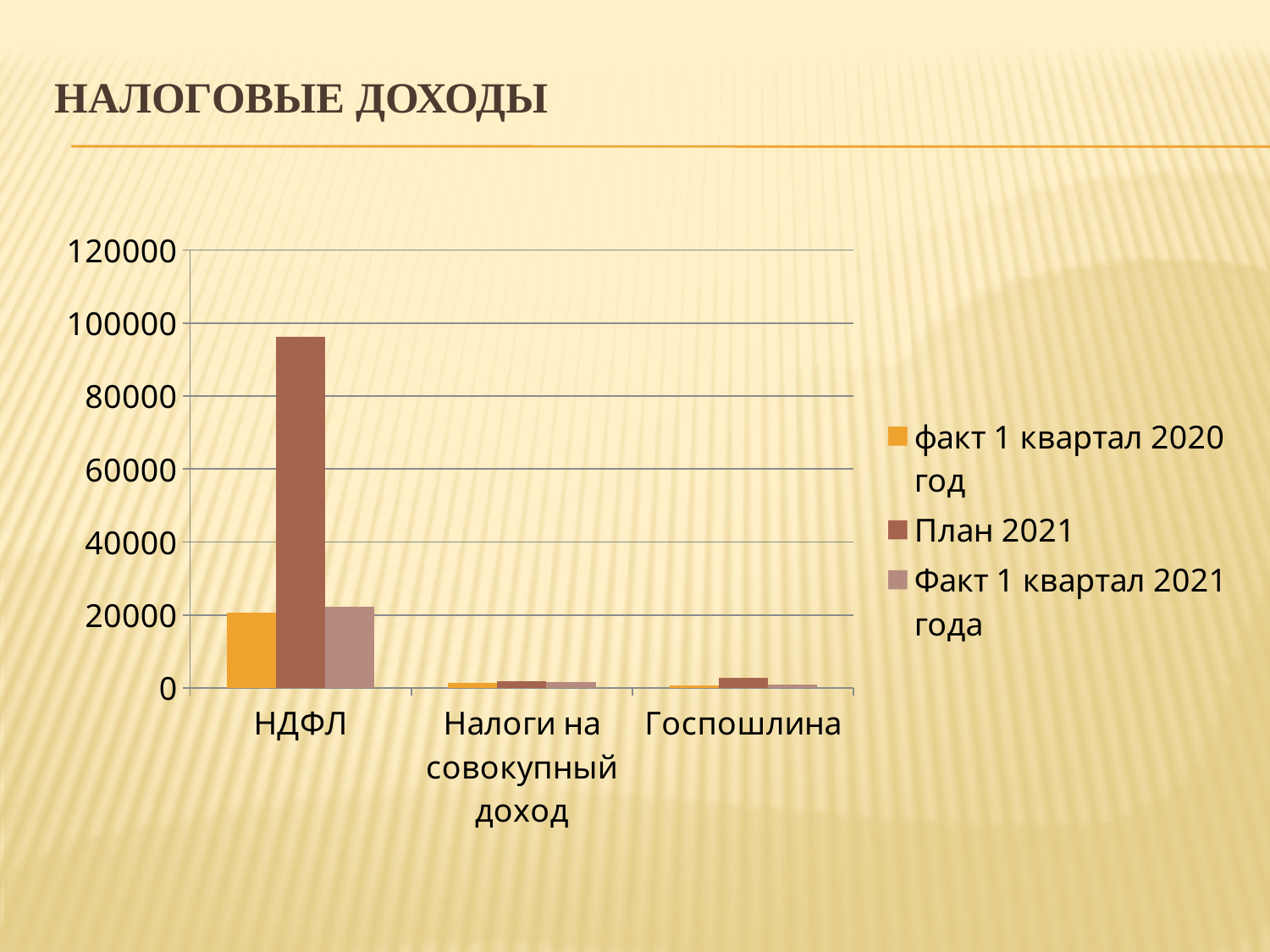
What kind of chart is shown on the slide? bar chart Which series is shown in orange in the legend? факт 1 квартал 2020 год Is the value of факт 1 квартал 2020 год for НДФЛ greater or less than 40000? less Is the value of План 2021 for НДФЛ greater or less than 100000? less For НДФЛ, which is larger: План 2021 or факт 1 квартал 2020 год? План 2021 Is the value of Факт 1 квартал 2021 года for НДФЛ greater or less than 40000? less How many categories are shown on the x axis of the chart? 3 What is the title of the slide? НАЛОГОВЫЕ ДОХОДЫ How many series does the legend list? 3 Which category has the lowest value for the series План 2021? Налоги на совокупный доход Which category has the highest value for the series План 2021? НДФЛ